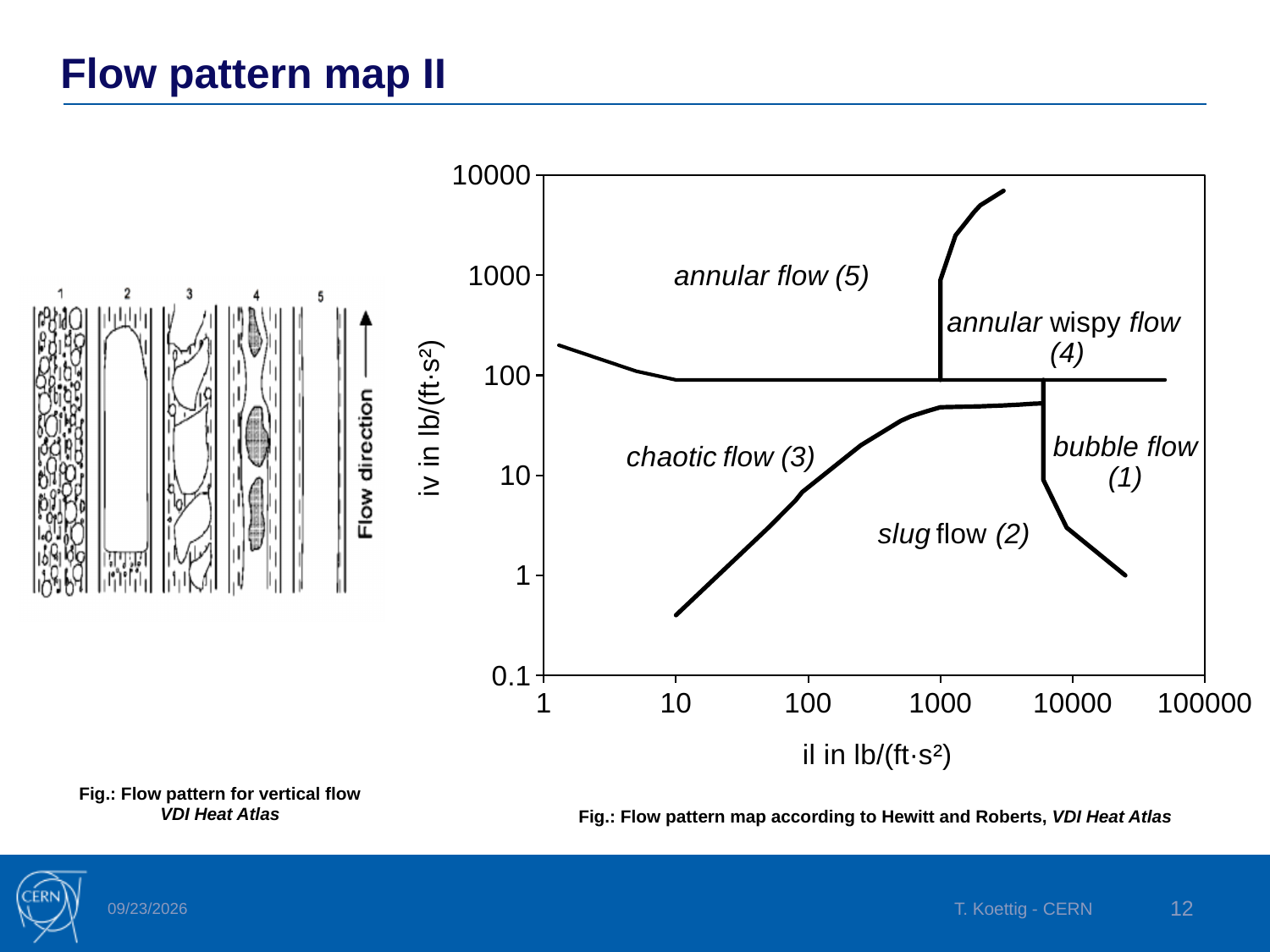
On the flow pattern map, at what il value is the vertical boundary between annular flow (5) and annular wispy flow (4)? 1000 On the flow pattern map, which number is assigned to bubble flow? (1) On the flow pattern map, which flow regime occupies the upper-left region of the chart? annular flow (5) On the flow pattern map, which flow regime lies directly below annular flow (5)? chaotic flow (3) How many flow regimes are labeled on the flow pattern map? 5 What is the label of the x axis of the flow pattern map? il in lb/(ft·s²) On the flow pattern map, which flow regime is labeled with the number (5)? annular flow What kind of chart is the flow pattern map on the right of the slide? line chart According to the caption, whose flow pattern map is shown on the slide? Hewitt and Roberts On the flow pattern map, which flow regime lies to the right of slug flow (2)? bubble flow (1) On the flow pattern map, is the vertical boundary between slug flow (2) and bubble flow (1) at an il value greater or less than 1000? greater What is the highest value shown on the y axis of the flow pattern map? 10000